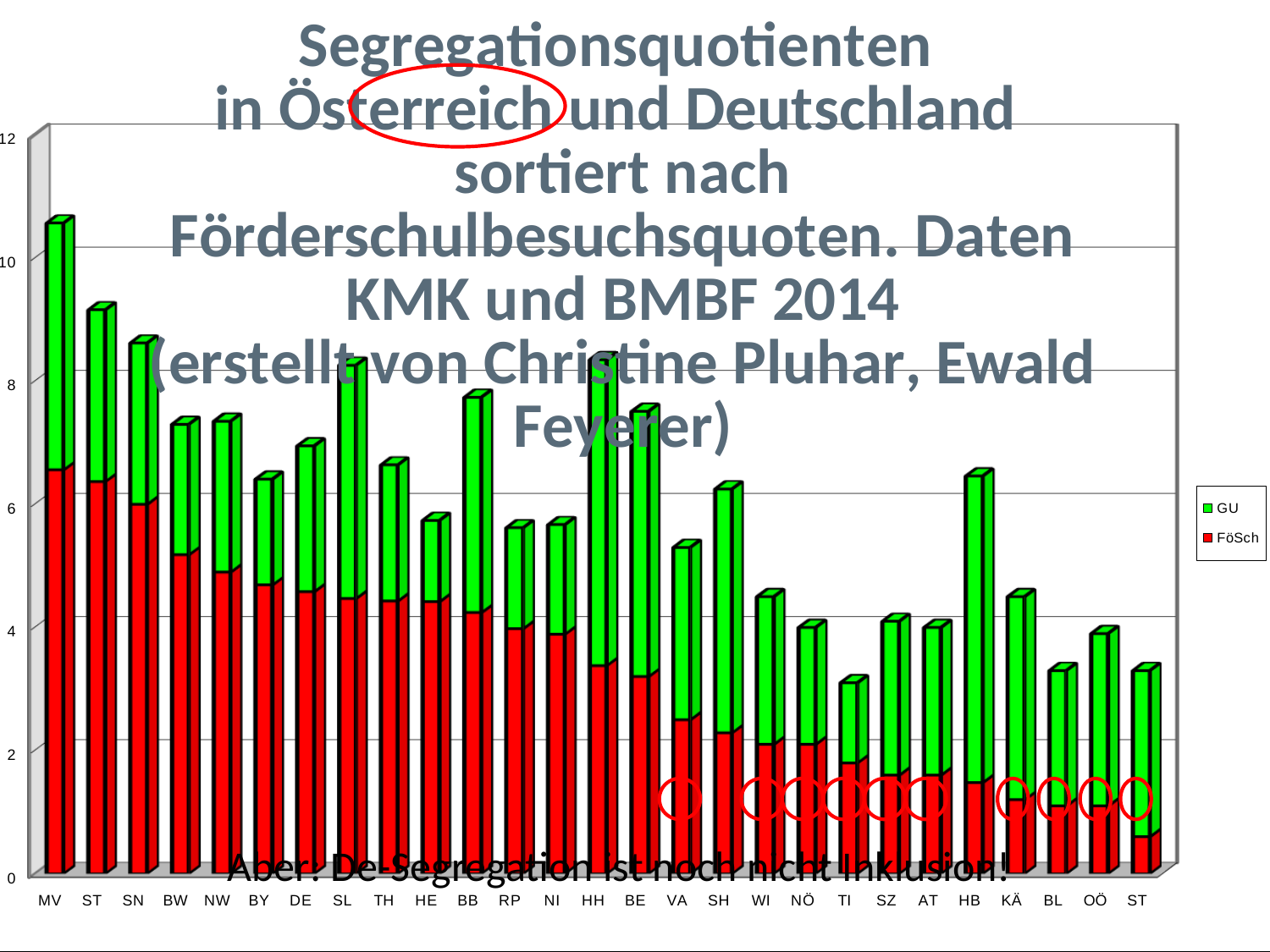
Is the total value for TI greater or less than 4? less How many series does the legend list? 2 Which category has the lowest FöSch (red) value? ST (rightmost bar) Which has the larger total bar, MV or HB? MV What kind of chart is shown on the slide? stacked bar chart Which colour represents the GU series in the legend? green Which category has the highest total bar? MV Do the FöSch (red) values generally rise or fall from left to right along the x axis? fall How many categories are shown on the x axis? 27 Is the FöSch value for HH greater or less than 4? less Is the total value for HB greater or less than 6? greater